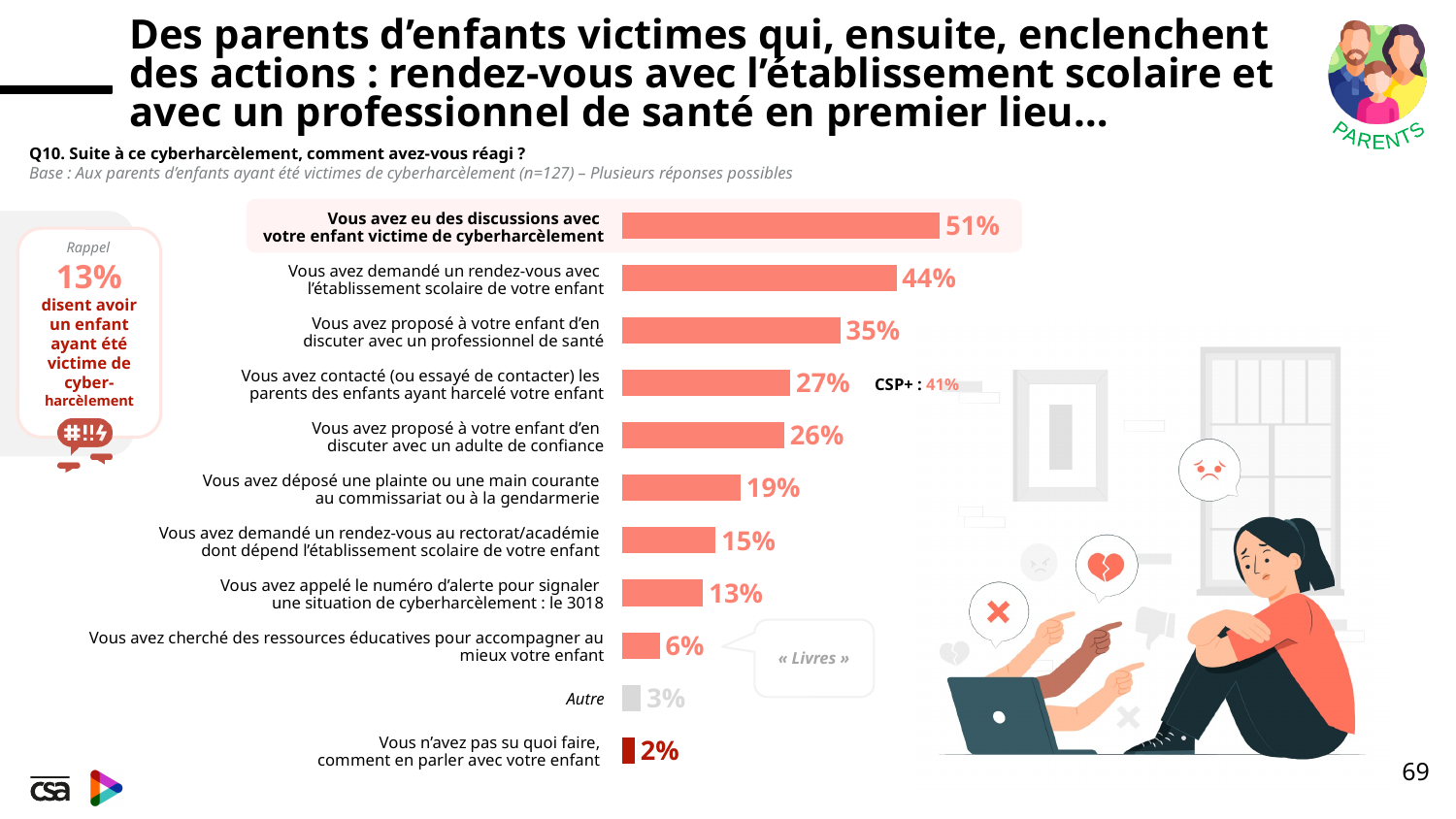
Which response has the highest percentage in the chart? Vous avez eu des discussions avec votre enfant victime de cyberharcèlement What is the difference in percentage points between having discussions with the child (51%) and requesting a meeting with the school (44%)? 7 points What is the value for "Vous avez demandé un rendez-vous avec l'établissement scolaire de votre enfant"? 44% Do the values rise or fall going from the top bar to the bottom bar? Fall What percentage of parents say they had discussions with their child who was a victim of cyberbullying? 51% What is the value for "Vous avez appelé le numéro d'alerte pour signaler une situation de cyberharcèlement : le 3018"? 13% What percentage of parents proposed that their child talk with a health professional? 35% Which response has the lowest percentage in the chart? Vous n'avez pas su quoi faire, comment en parler avec votre enfant What is the CSP+ value shown next to the bar for contacting the parents of the children who bullied your child? 41% What kind of chart is shown on the slide? Bar chart Which is larger: the share of parents who filed a complaint at the police station (plainte ou main courante) or the share who requested a meeting with the rectorat/académie? Plainte ou main courante (19%) How many response categories are plotted in the bar chart? 11